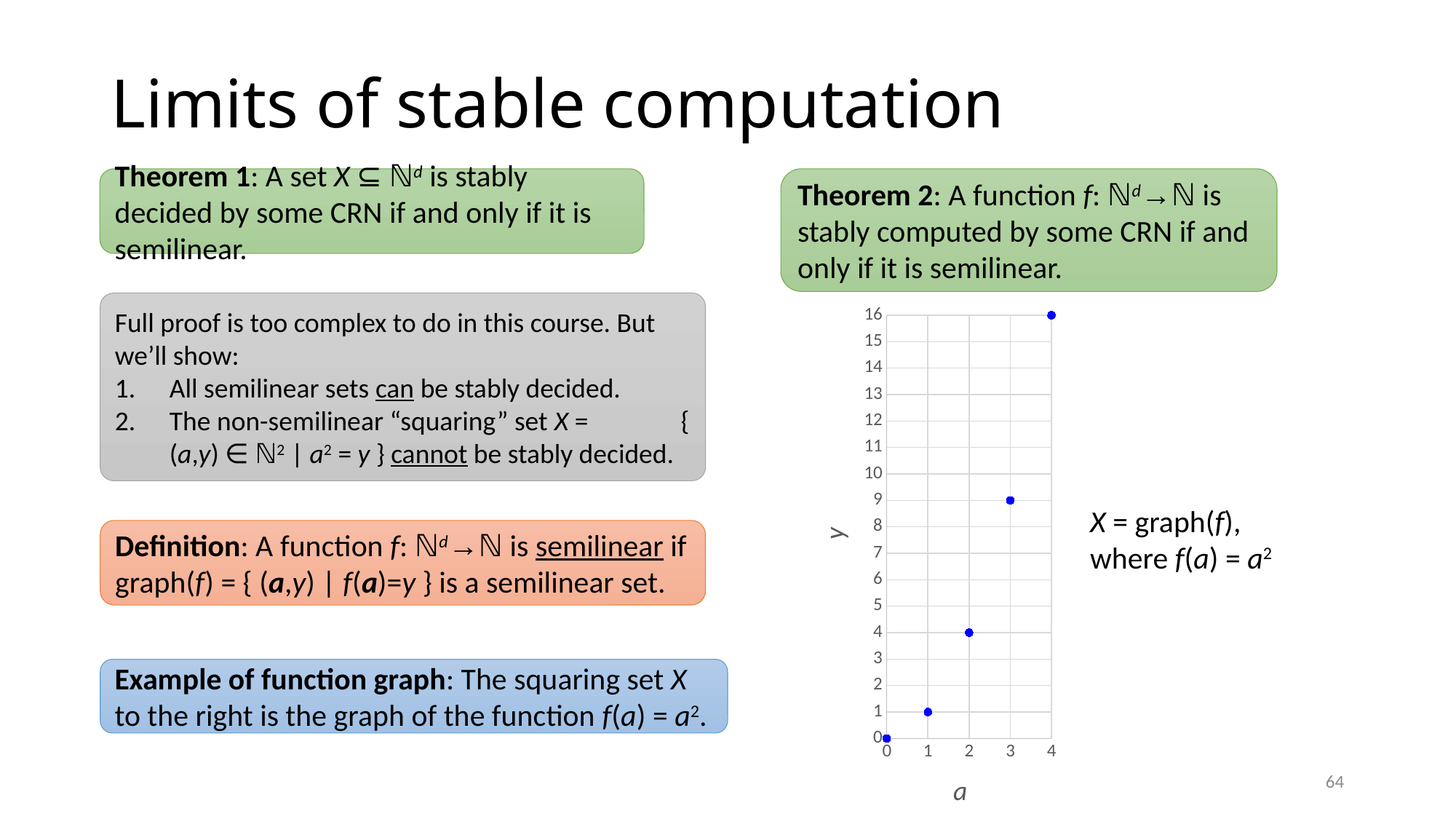
How many data points are plotted in the chart? 5 At which value of a is the plotted y value lowest? 0 What is the difference between the y values at a = 4 and a = 3? 7 What is the y value of the point at a = 4? 16 Which has the larger y value: the point at a = 2 or the point at a = 3? a = 3 At which value of a is the plotted y value highest? 4 What is the label on the horizontal axis of the chart? a Do the y values rise or fall as a increases along the x axis? rise What is the y value of the point at a = 2? 4 What is the y value of the point at a = 3? 9 What kind of chart is shown on the slide? scatter plot What is the y value of the point at a = 1? 1